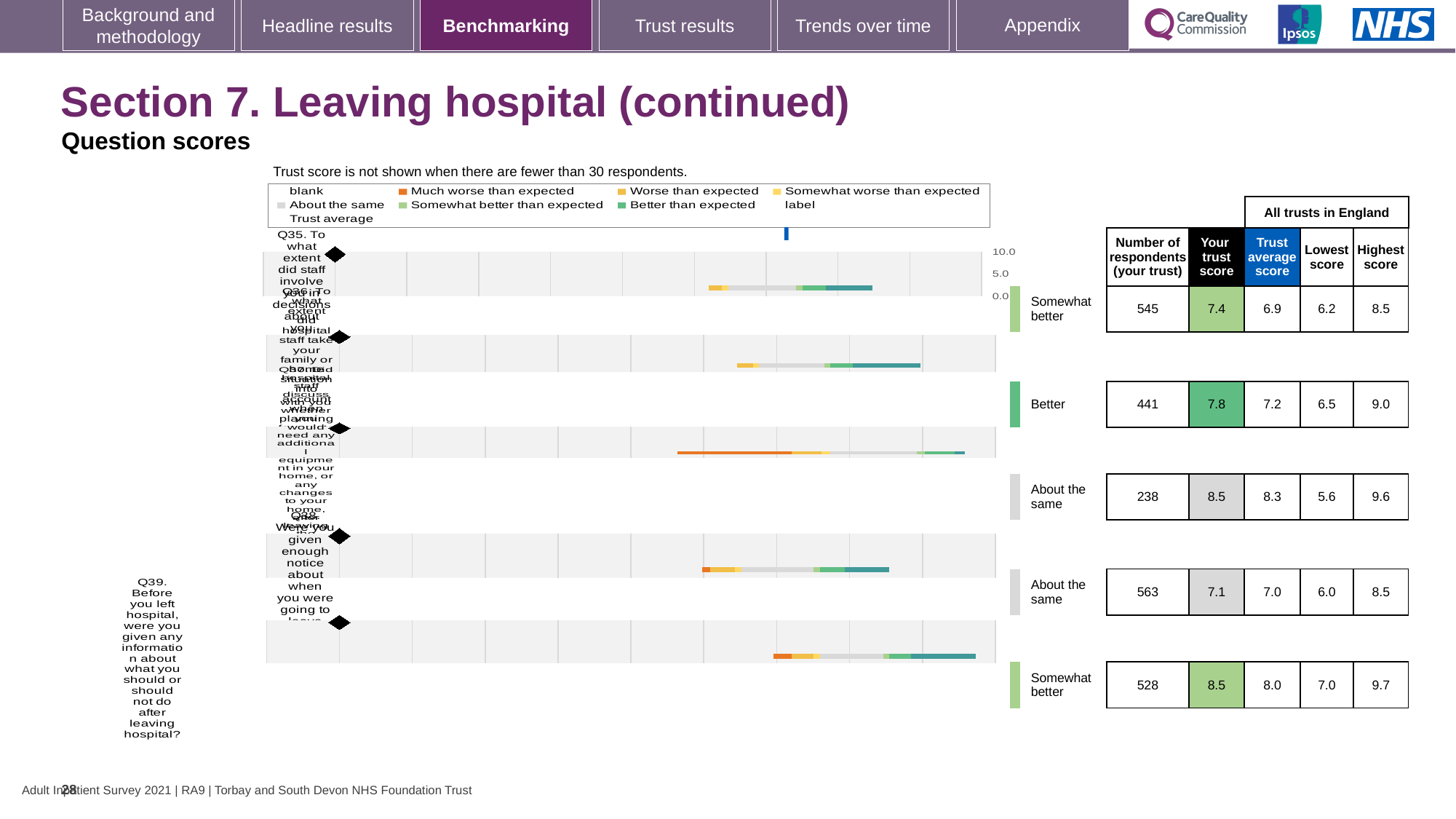
What is the trust score for Q35 (the first question row) on the slide? 7.4 What is the difference between the trust score and the trust average score for Q35 (the first question row)? 0.5 What is the maximum value shown on the chart's score axis? 10.0 What benchmark category is shown for Q35 (the first question row)? Somewhat better How many question rows are shown in the benchmarking chart? 5 How many respondents from the trust answered Q39 (the last question row)? 528 Which question row has the lowest number of respondents? The third row (238 respondents) What is the highest score among all trusts in England for Q39 (the last question row)? 9.7 What is the trust average score for all trusts in England for Q39 (the last question row)? 8.0 Is the trust score for Q39 (the last question row) higher or lower than the trust average score for that question? Higher What colour in the legend represents 'Much worse than expected'? Orange Which question row has the highest number of respondents? The fourth row (563 respondents)